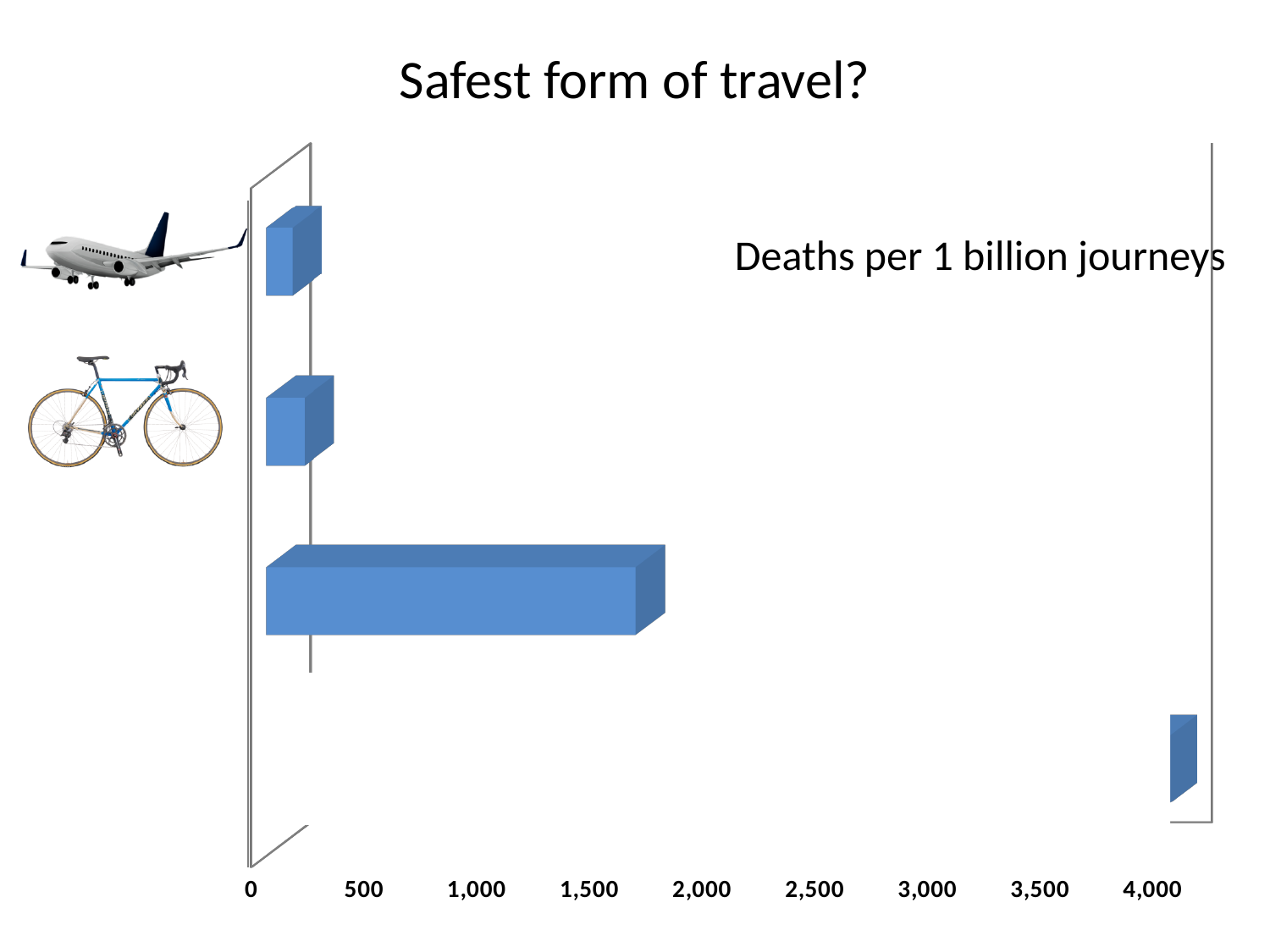
Is the value of the third bar from the top greater or less than 2,000? less Is the value of the second bar from the top (next to the bicycle image) greater or less than 500? less What does the text label on the chart say the values represent? Deaths per 1 billion journeys What kind of chart is shown on the slide? Bar chart What is the title of the slide containing the chart? Safest form of travel? What is the highest tick value shown on the horizontal axis? 4,000 Is the value of the third bar from the top greater or less than 1,500? greater How many bars are plotted in the chart? 4 Among the top three bars, which one has the highest value? The third bar from the top Which is larger: the value of the top bar or the value of the third bar from the top? The third bar from the top